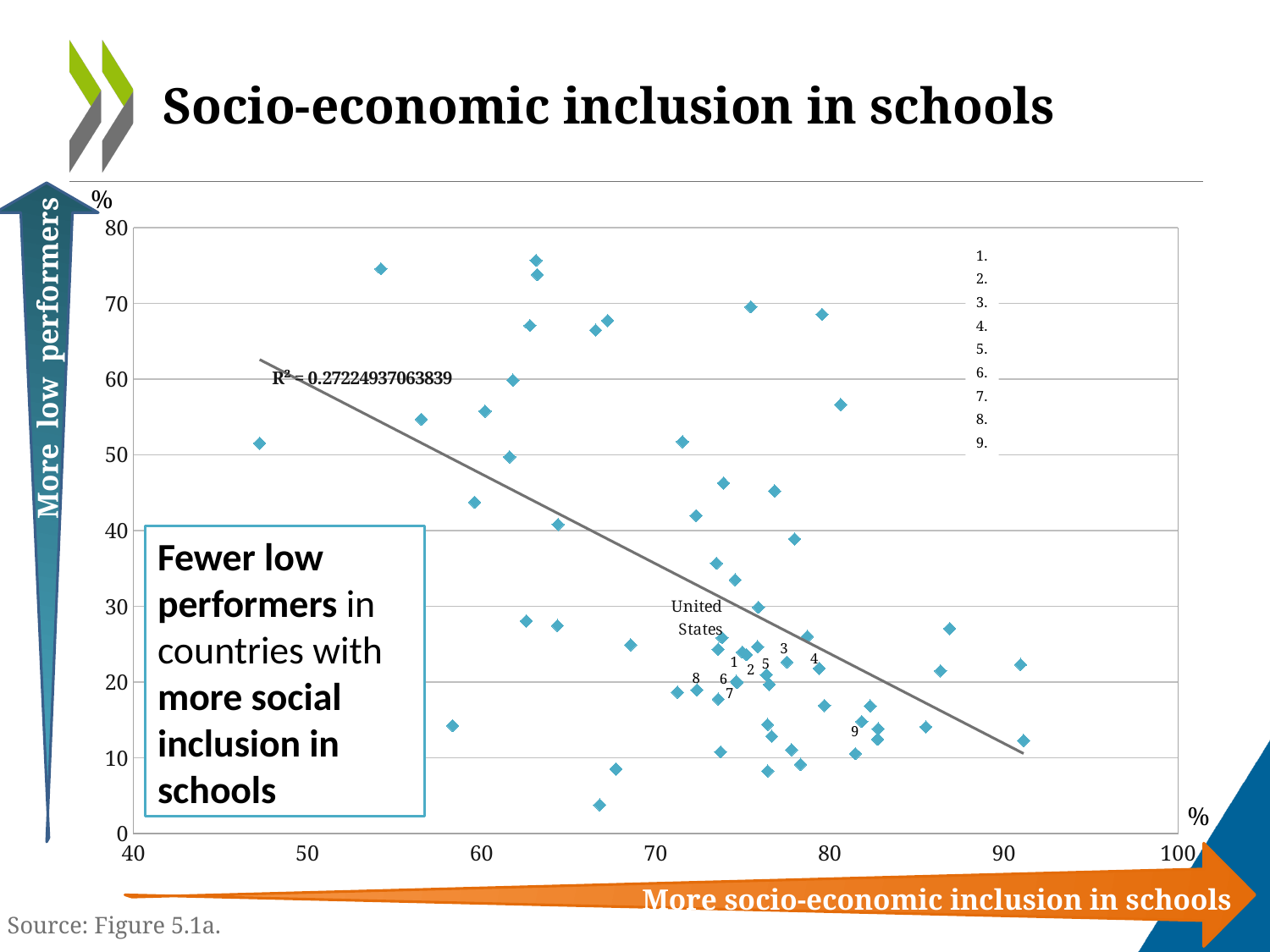
What kind of chart is shown on the slide? scatter chart Which country is labelled by name on the chart? United States What is the lowest value shown on the horizontal axis? 40 Is the lowest share of low performers plotted on the chart greater or less than 10? less As socio-economic inclusion in schools increases along the x axis, does the share of low performers tend to rise or fall? fall Is the share of low performers for the United States greater or less than 10? greater Is the share of low performers for the United States greater or less than 40? less What is the title of the slide's chart? Socio-economic inclusion in schools What R² value is printed next to the trend line? R² = 0.27224937063839 What is the highest value shown on the vertical axis? 80